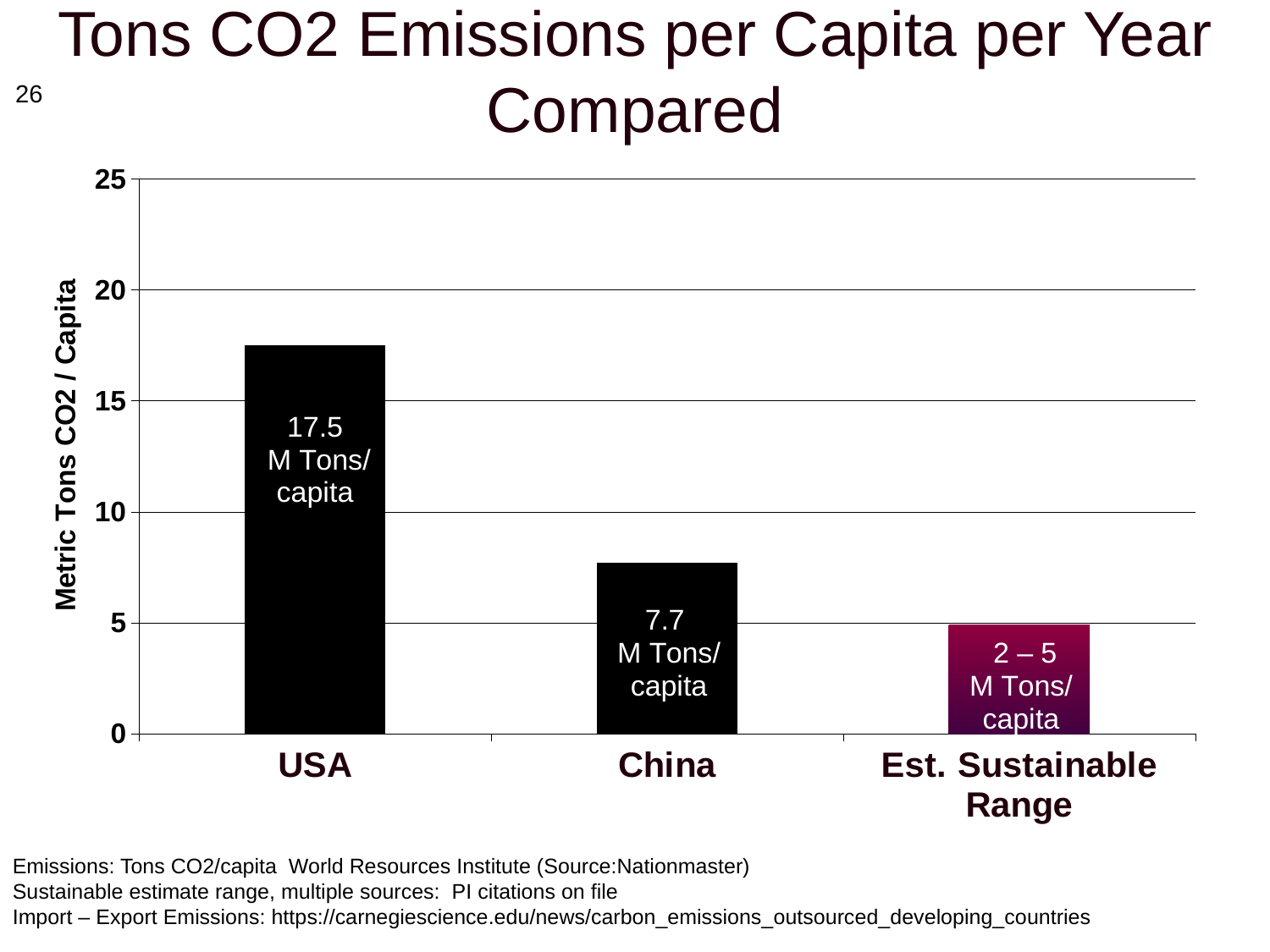
Which category has the highest value? USA Which is larger, the value for USA or the value for China? USA What is the difference between the USA and China values? 9.8 What is the label of the y axis? Metric Tons CO2 / Capita Is the value for USA greater or less than 15? greater How many categories are shown on the x axis? 3 What kind of chart is shown on the slide? bar chart What value is labelled on the Est. Sustainable Range bar? 2 – 5 M Tons/capita What is the value for China? 7.7 M Tons/capita What is the value for USA? 17.5 M Tons/capita Is the value for China greater or less than 10? less Which category has the lowest value? Est. Sustainable Range